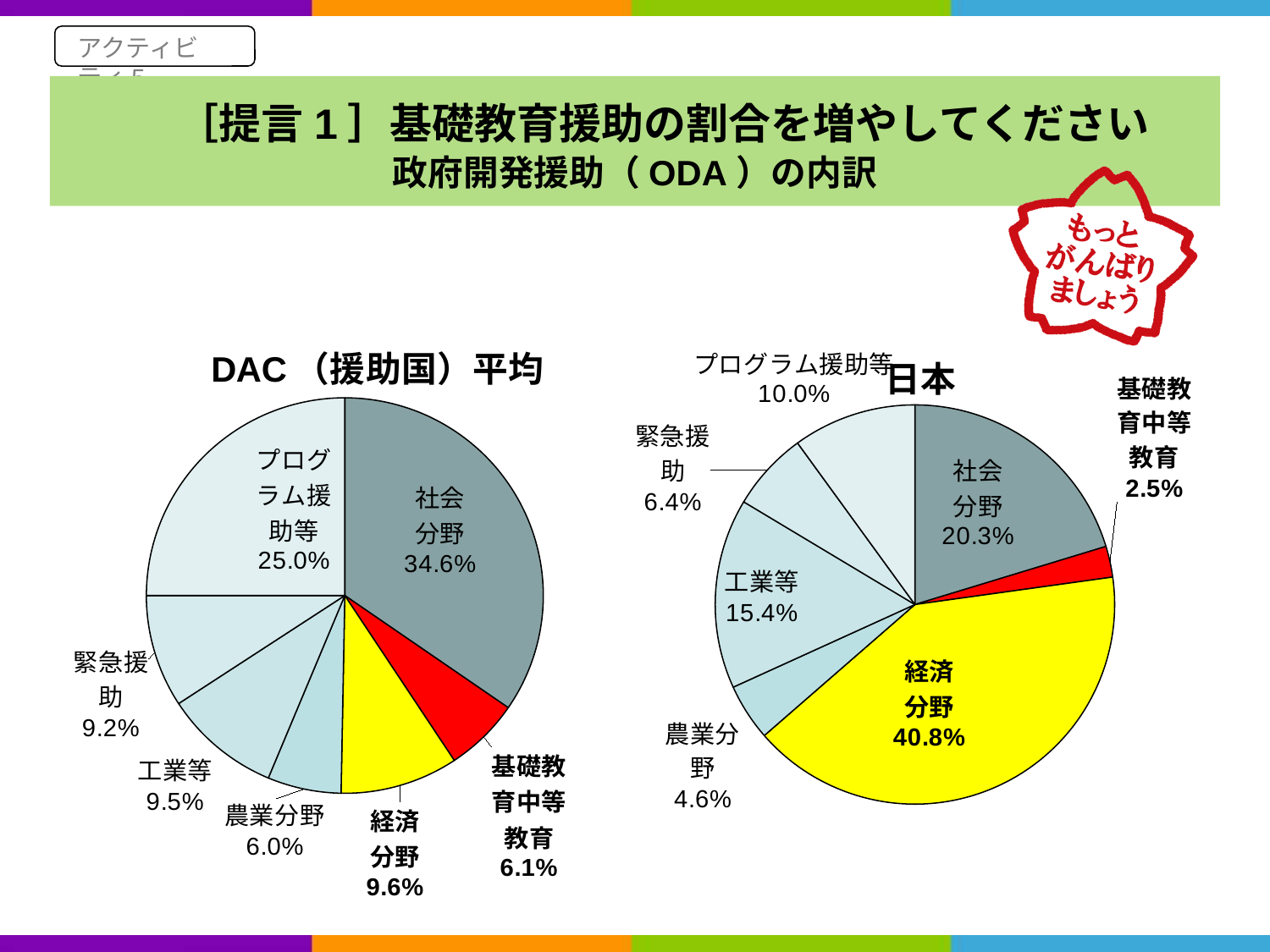
What type of chart is used for 日本? Pie chart In the 日本 chart, what share does 基礎教育中等教育 have? 2.5% In the DAC（援助国）平均 chart, which category has the smallest share? 農業分野 What is the difference between the 基礎教育中等教育 share in the DAC（援助国）平均 chart and in the 日本 chart? 3.6% How many slices does the DAC（援助国）平均 pie chart have? 7 In both charts, what colour is the 基礎教育中等教育 slice? Red In the 日本 chart, what share does 経済分野 have? 40.8% In the 日本 chart, which is larger: 工業等 or 緊急援助? 工業等 In the 日本 chart, which category has the smallest share? 基礎教育中等教育 In the DAC（援助国）平均 chart, what share does 社会分野 have? 34.6% In the 日本 chart, which category has the largest share? 経済分野 In the DAC（援助国）平均 chart, what share does プログラム援助等 have? 25.0%